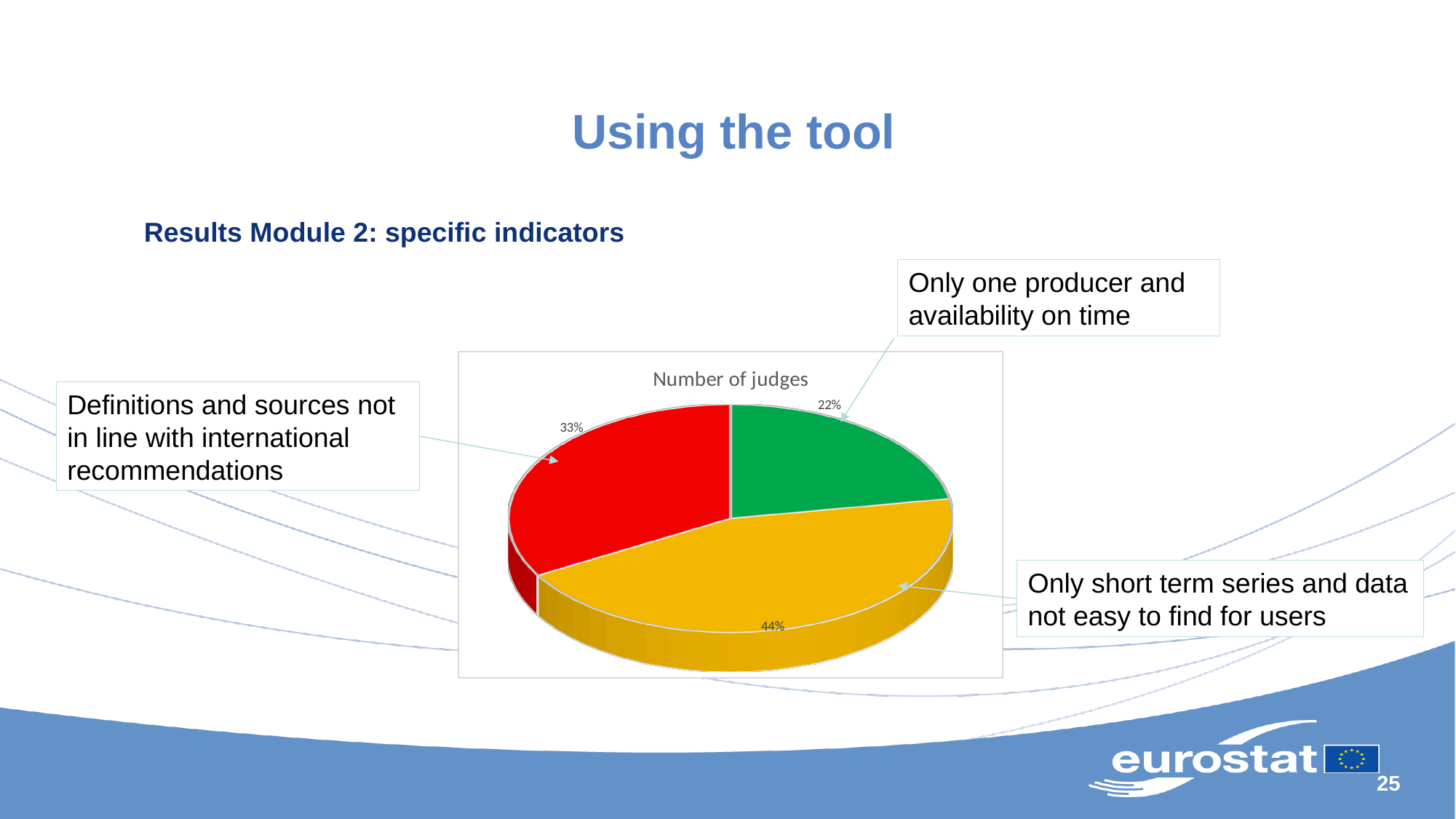
What colour is the slice representing 'Definitions and sources not in line with international recommendations'? red What share of the pie is the red slice labelled 'Definitions and sources not in line with international recommendations'? 33% Which is larger: the 'Definitions and sources not in line with international recommendations' slice or the 'Only one producer and availability on time' slice? Definitions and sources not in line with international recommendations What is the title of the chart? Number of judges How many slices does the pie chart have? 3 Which slice of the pie is the smallest? Only one producer and availability on time What share of the pie is the green slice labelled 'Only one producer and availability on time'? 22% What kind of chart is shown on the slide? pie chart What is the difference in percentage points between the 33% slice and the 22% slice? 11 What share of the pie is the yellow slice labelled 'Only short term series and data not easy to find for users'? 44% Which slice of the pie is the largest? Only short term series and data not easy to find for users What is the difference in percentage points between the 'Only short term series and data not easy to find for users' slice and the 'Only one producer and availability on time' slice? 22